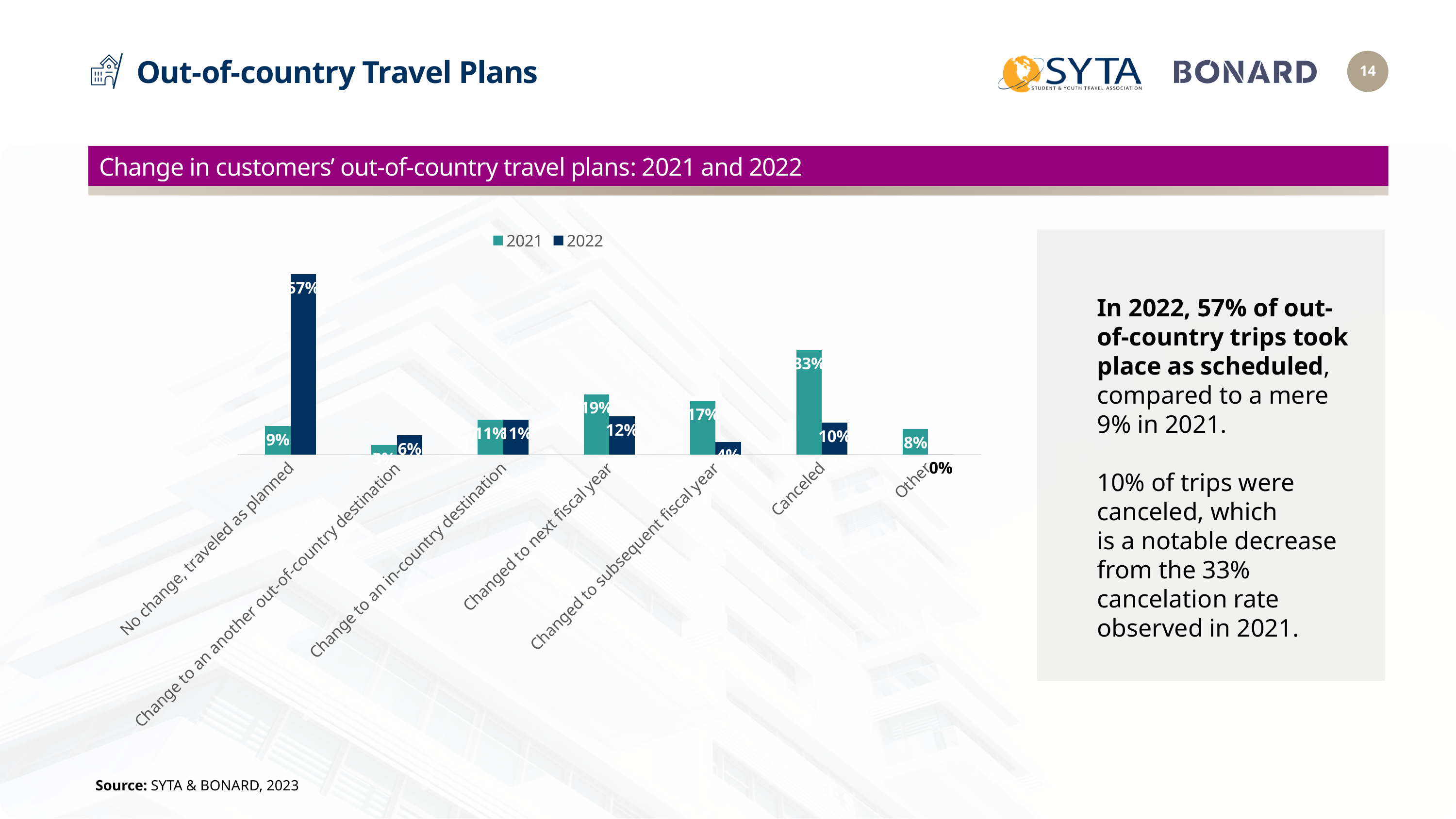
Which category had the highest value in 2021? Canceled Which category had the highest value in 2022? No change, traveled as planned What was the value for 'Other' in 2022? 0% What was the value for 'Canceled' in 2022? 10% What was the value for 'No change, traveled as planned' in 2021? 9% What was the value for 'No change, traveled as planned' in 2022? 57% What was the value for 'Canceled' in 2021? 33% What is the difference between the 2021 and 2022 values for 'Canceled'? 23% How many series does the legend list? 2 Which is larger for 'Changed to next fiscal year': the 2021 value or the 2022 value? 2021 What type of chart is shown on the slide? Bar chart What was the value for 'Changed to next fiscal year' in 2021? 19%